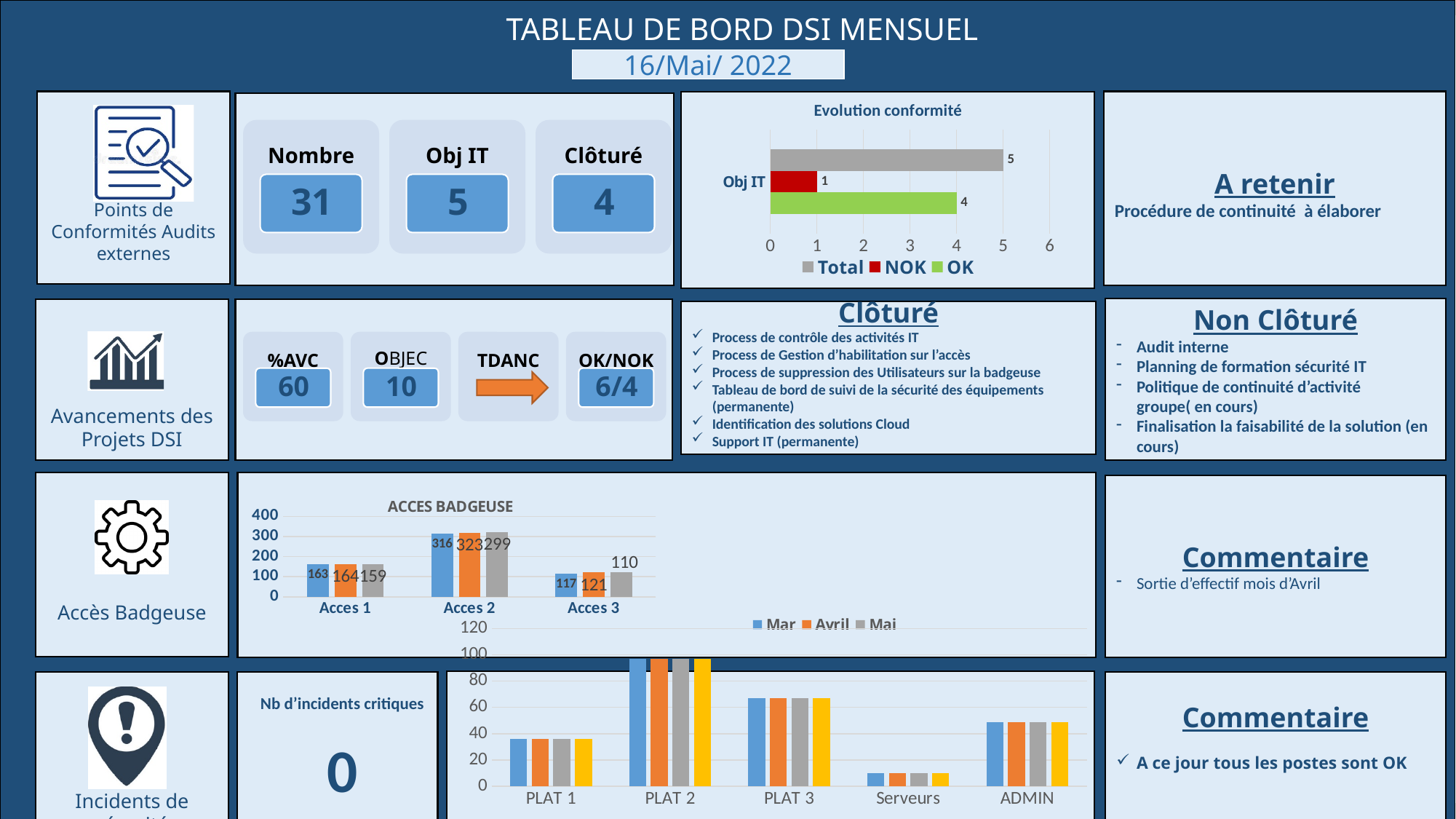
In the bottom chart with PLAT 1 to ADMIN, is the value for Serveurs greater or less than 20? less In the 'ACCES BADGEUSE' chart, what is the value for Acces 2 in Avril? 323 In the 'ACCES BADGEUSE' chart, how many categories are shown on the x axis? 3 In the 'Evolution conformité' chart, what is the difference between the OK value and the NOK value? 3 In the 'ACCES BADGEUSE' chart, which is larger for Acces 1: the Mar value or the Mai value? Mar In the 'ACCES BADGEUSE' chart, what is the value for Acces 3 in Mai? 110 In the 'Evolution conformité' chart, what is the value of the Total series for Obj IT? 5 In the 'Evolution conformité' chart, what is the value of the NOK series? 1 In the 'Evolution conformité' chart, how many series does the legend list? 3 In the 'ACCES BADGEUSE' chart, what is the difference between the Mar and Mai values for Acces 2? 17 In the bottom chart with PLAT 1 to ADMIN, what kind of chart is it? bar chart In the 'ACCES BADGEUSE' chart, which category has the highest values? Acces 2